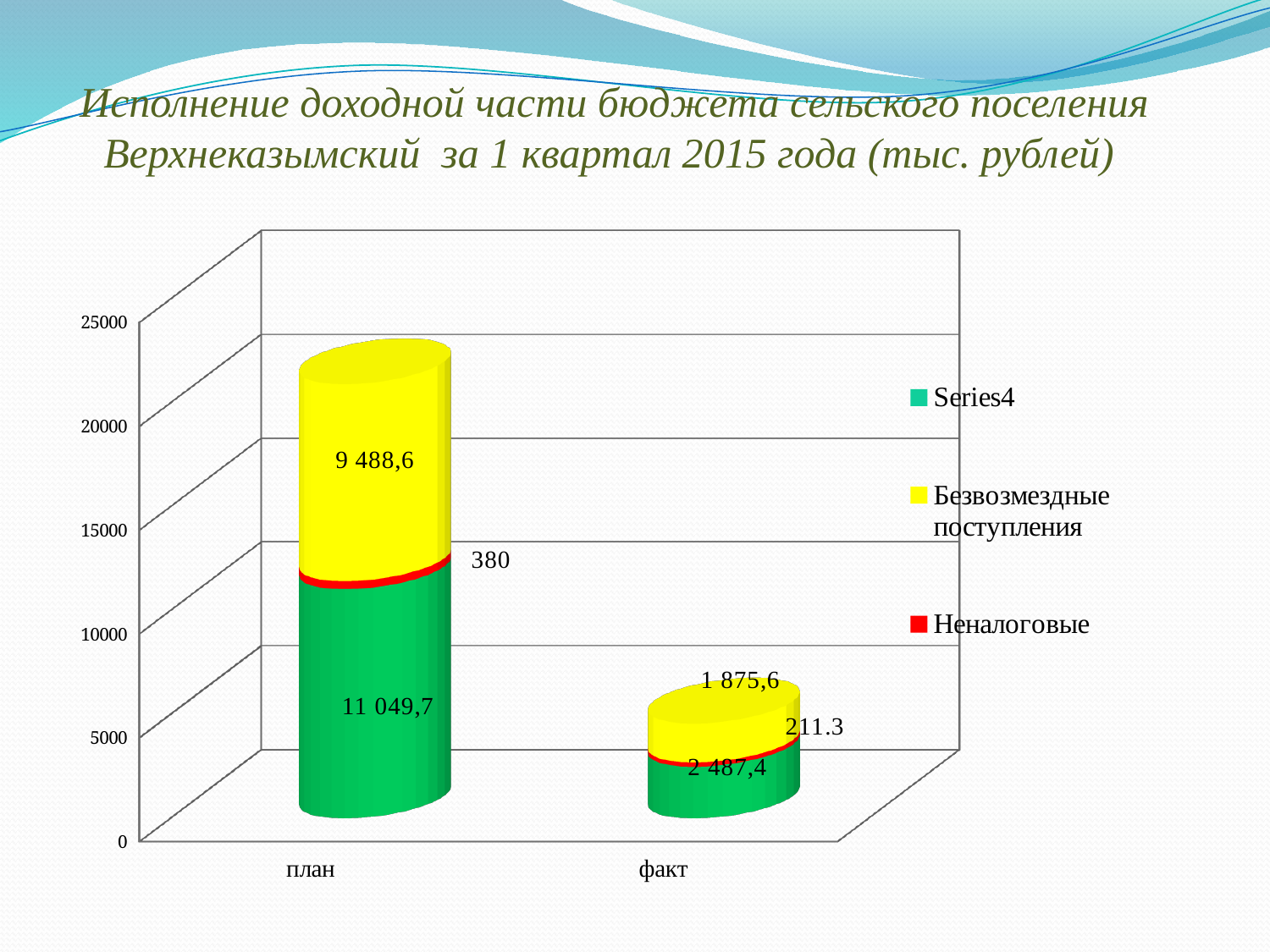
What is the value of Неналоговые for план? 380 How many categories are shown on the x axis? 2 What is the value of Неналоговые for факт? 211.3 Which colour represents Неналоговые in the legend? red How many series does the legend list? 3 What is the value of Безвозмездные поступления for факт? 1 875,6 What type of chart is shown on the slide? stacked bar chart What is the total of the stacked bar for план? 20 918,3 Which category has the higher value for Безвозмездные поступления, план or факт? план What is the total of the stacked bar for факт? 4 574,3 What is the value of Series4 for план? 11 049,7 What is the difference between the Series4 values for план and факт? 8 562,3